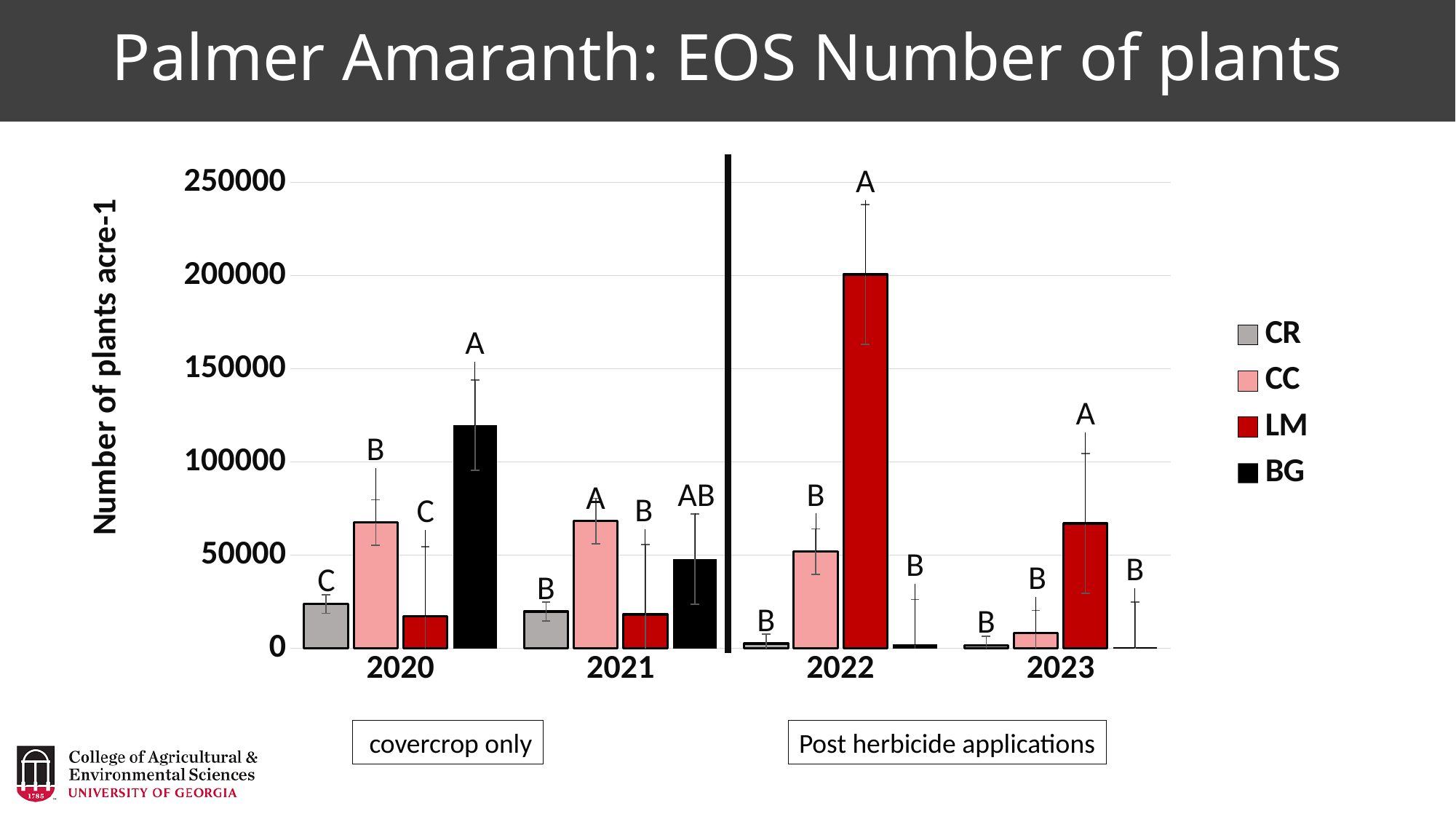
Is the value for LM in 2022 greater or less than 150000? greater How many series does the legend list? 4 Which series has the highest value in 2022? LM What kind of chart is shown on the slide? bar chart Which series has the highest value in 2020? BG Is the value for BG in 2020 greater or less than 100000? greater Is the value for CC in 2023 greater or less than 50000? less In 2021, which is larger, the value for CC or the value for BG? CC How many years are shown on the x axis? 4 In 2020, which is larger, the value for CC or the value for CR? CC Does the CR series rise or fall from 2020 to 2023? fall What is the label on the y axis? Number of plants acre-1